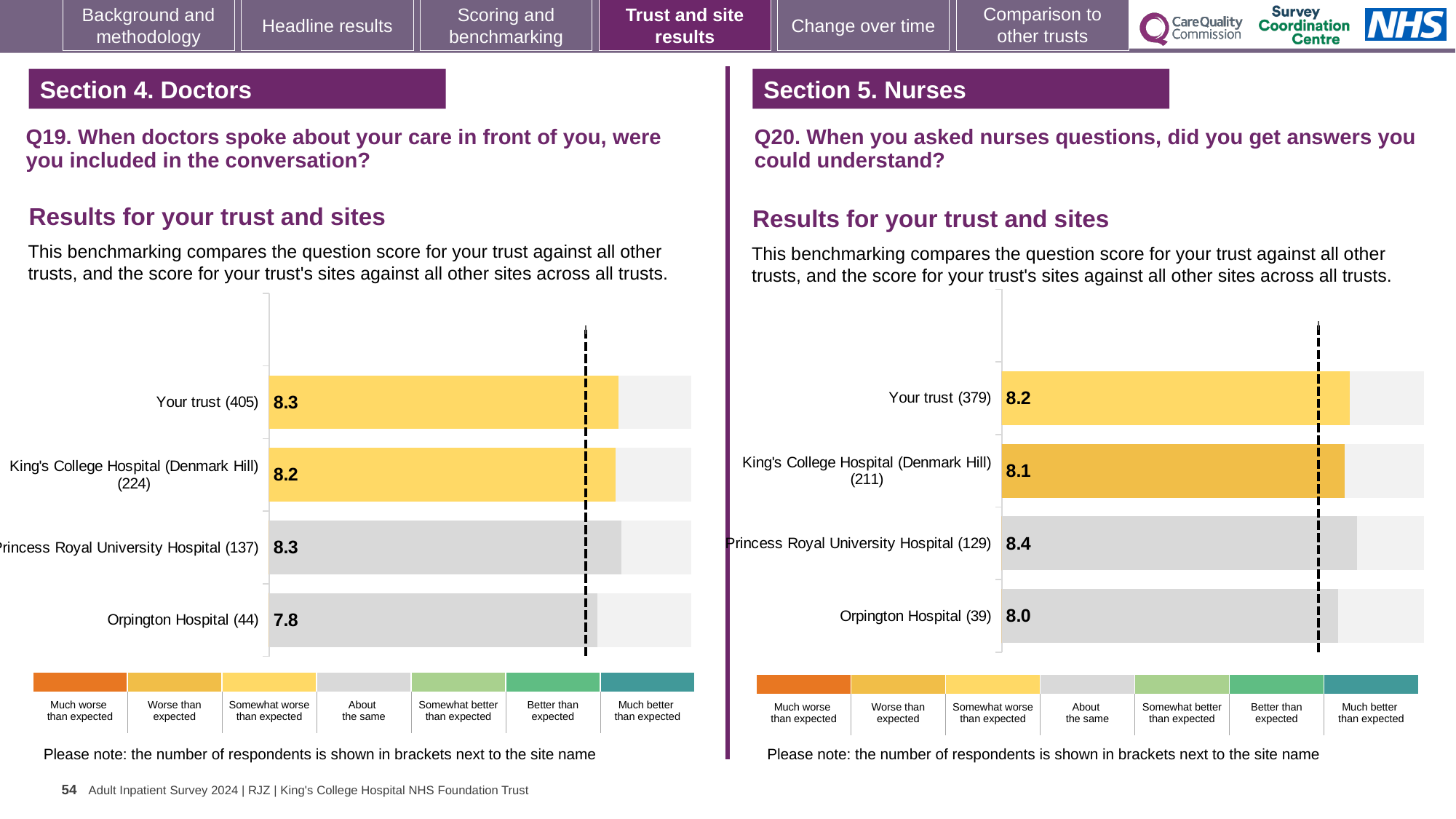
On the Q19 chart (left), what is the difference between the score for Your trust and the score for Orpington Hospital? 0.5 On the Q20 chart (right), which site or trust has the highest score? Princess Royal University Hospital On the Q19 chart (left), what is the score for King's College Hospital (Denmark Hill)? 8.2 On the Q20 chart (right), what is the score for Princess Royal University Hospital? 8.4 On the Q19 chart (left), what is the score for Orpington Hospital? 7.8 On the Q19 chart (left), which site or trust has the lowest score? Orpington Hospital What type of chart is used for the Q20 results (right)? Bar chart On the Q20 chart (right), what is the score for Your trust? 8.2 On the Q20 chart (right), which site or trust has the lowest score? Orpington Hospital On the Q20 chart (right), which has the higher score: Your trust or Orpington Hospital? Your trust How many bars are shown on the Q19 chart (left)? 4 On the Q20 chart (right), what is the difference between the score for Princess Royal University Hospital and the score for King's College Hospital (Denmark Hill)? 0.3